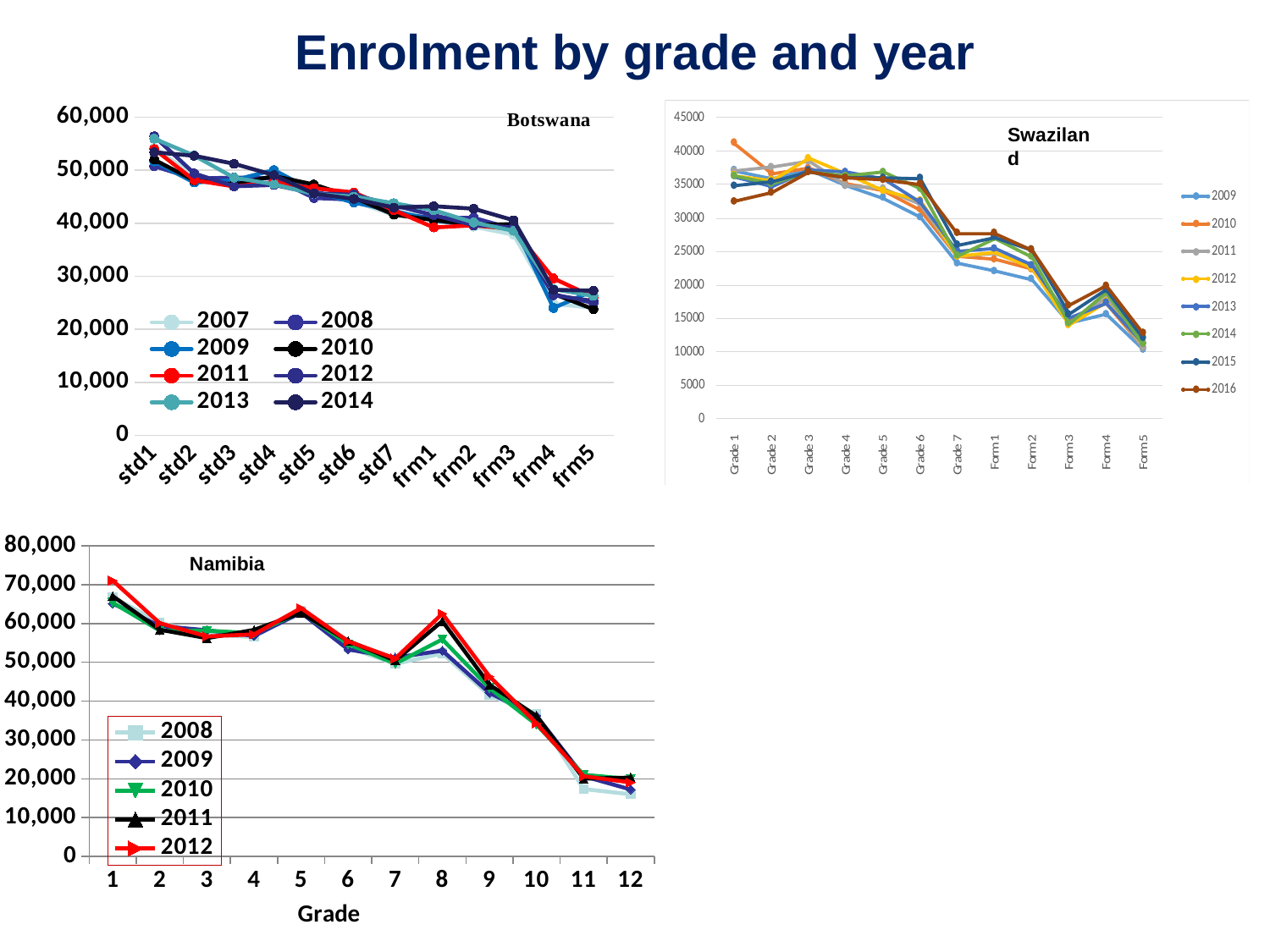
In the Swaziland chart, is the 2016 value for Form 5 greater or less than 15000? less In the Swaziland chart, which year has the highest enrolment at Grade 1? 2010 What is the x-axis title of the Namibia chart? Grade How many grade categories are shown on the x axis of the Botswana chart? 12 What kind of chart is the Botswana chart? line chart In the Namibia chart, is the 2012 value for grade 1 greater or less than 60,000? greater In the Namibia chart, which is larger at grade 8: the 2012 value or the 2009 value? 2012 How many series does the legend of the Namibia chart list? 5 In the Namibia chart, do the values rise or fall from grade 8 to grade 12? fall In the Botswana chart, is the 2009 value for frm4 greater or less than 30,000? less How many series does the legend of the Swaziland chart list? 8 In the Namibia chart, which year has the highest enrolment at grade 1? 2012